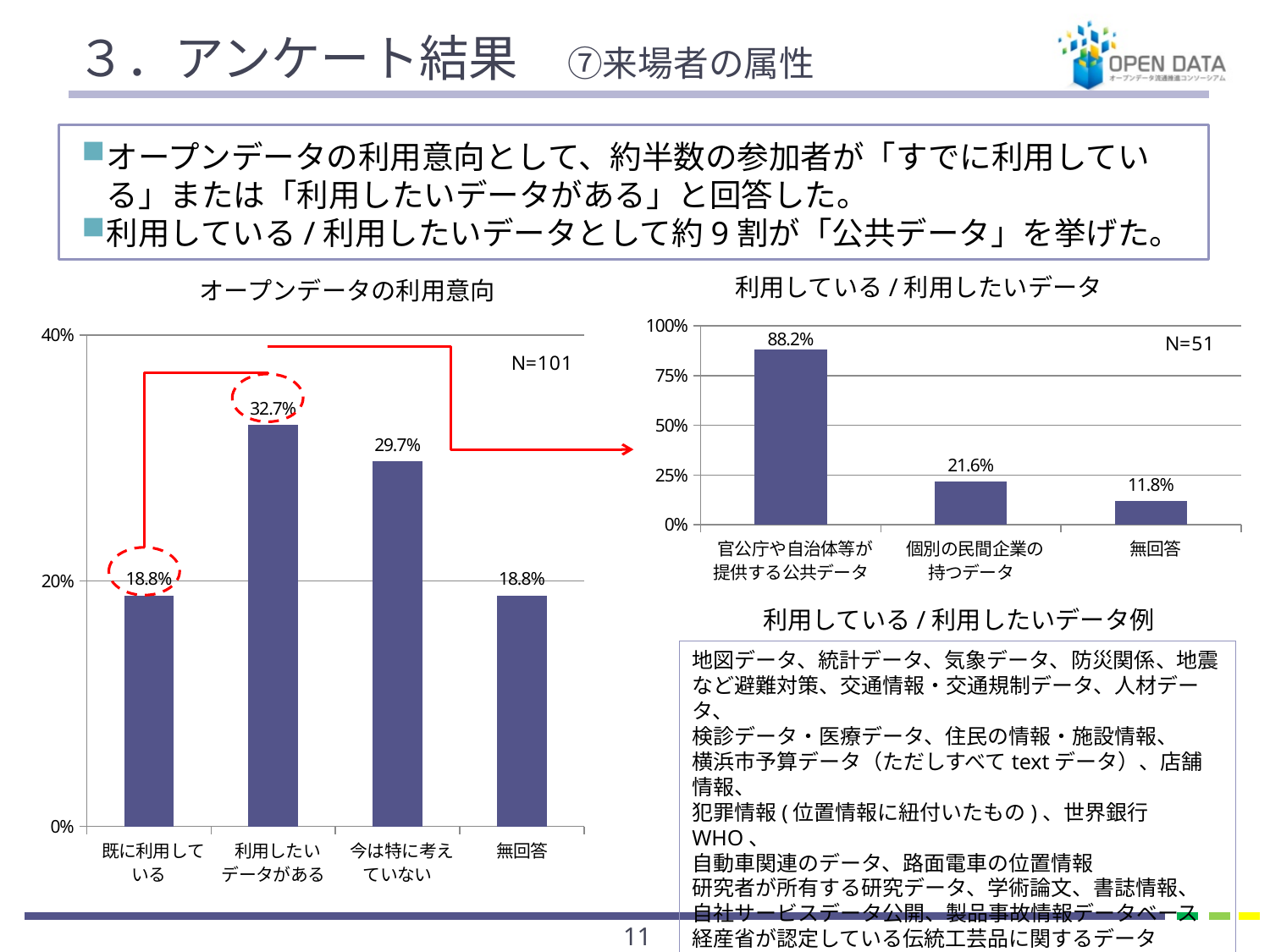
In the chart titled 利用している/利用したいデータ, what is the value for 無回答? 11.8% In the chart titled オープンデータの利用意向, what is the sample size (N) shown? N=101 In the chart titled 利用している/利用したいデータ, which category has the lowest value? 無回答 In the chart titled オープンデータの利用意向, what is the value for 利用したいデータがある? 32.7% In the chart titled オープンデータの利用意向, what is the difference between 利用したいデータがある and 既に利用している? 13.9% In the chart titled 利用している/利用したいデータ, what is the value for 官公庁や自治体等が提供する公共データ? 88.2% What kind of chart is the chart titled 利用している/利用したいデータ? bar chart In the chart titled 利用している/利用したいデータ, what is the difference between 官公庁や自治体等が提供する公共データ and 個別の民間企業の持つデータ? 66.6% In the chart titled 利用している/利用したいデータ, is the value for 個別の民間企業の持つデータ greater or less than 25%? less In the chart titled オープンデータの利用意向, which category has the highest value? 利用したいデータがある In the chart titled オープンデータの利用意向, what is the value for 今は特に考えていない? 29.7% In the chart titled オープンデータの利用意向, how many categories are shown on the x axis? 4